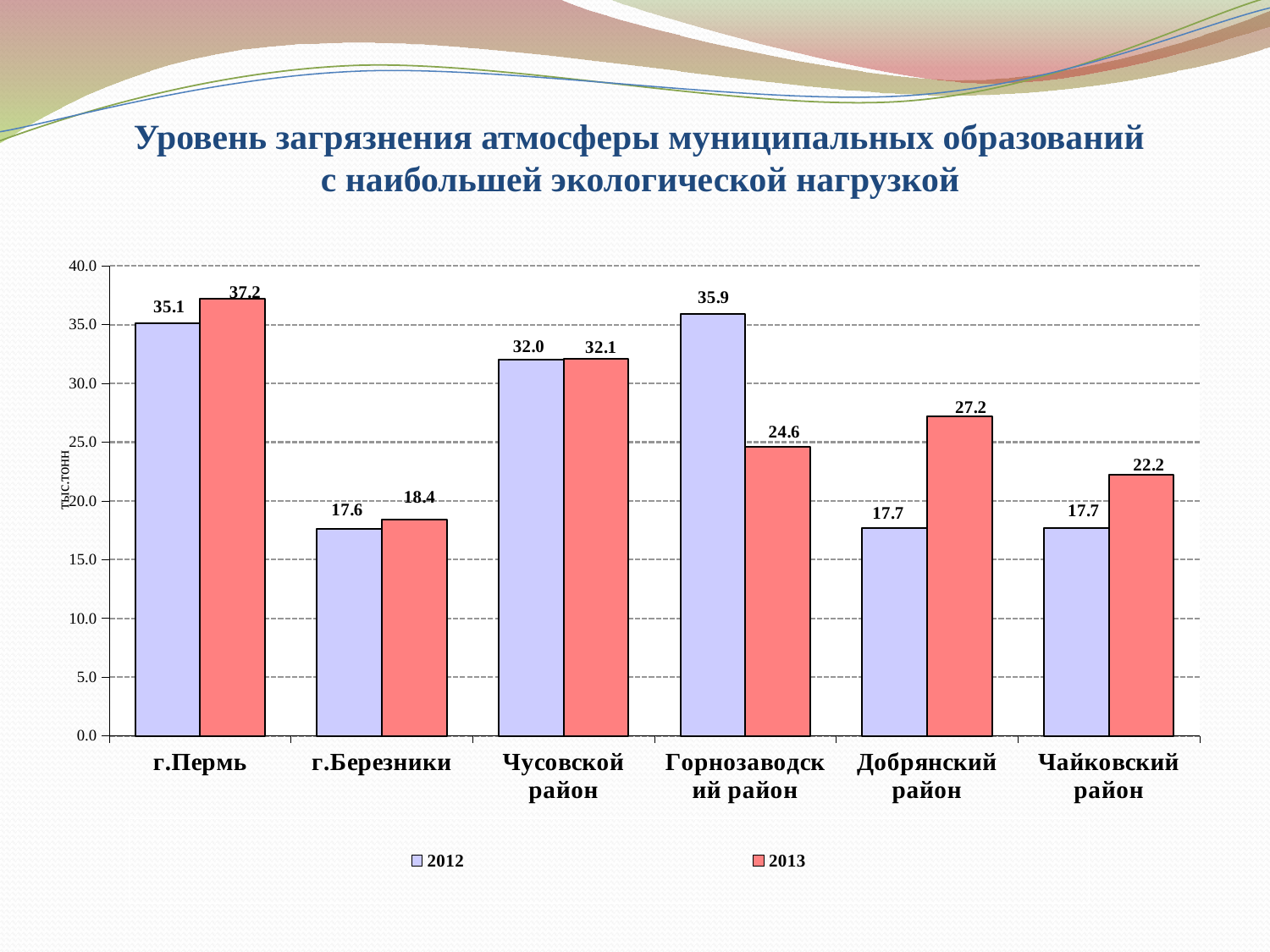
Which is larger for Чайковский район: the 2012 value or the 2013 value? 2013 How many series does the legend list? 2 What kind of chart is shown on the slide? bar chart What is the 2013 value for Добрянский район? 27.2 What unit is shown on the y axis label? тыс.тонн How many categories are shown on the x axis? 6 What is the difference between the 2012 and 2013 values for Горнозаводский район? 11.3 What is the difference between the 2013 and 2012 values for г.Пермь? 2.1 Which category has the highest 2013 value? г.Пермь What is the 2012 value for г.Пермь? 35.1 What is the 2013 value for Горнозаводский район? 24.6 Which category has the lowest 2012 value? г.Березники